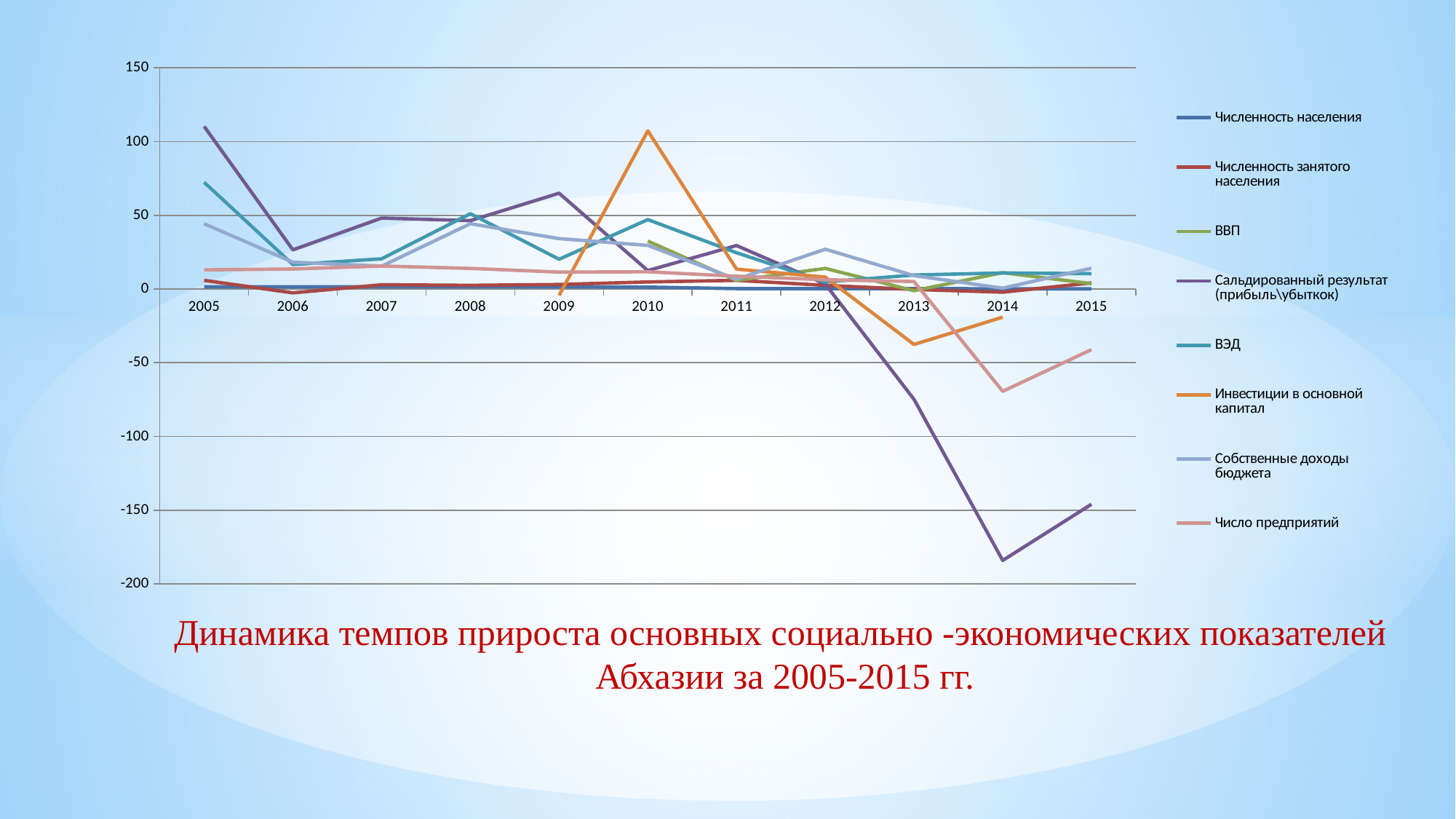
How many years are shown on the x axis? 11 In 2005, which is higher: Сальдированный результат (прибыль\убыток) or ВЭД? Сальдированный результат (прибыль\убыток) What kind of chart is shown on the slide? line chart Is the value for Сальдированный результат (прибыль\убыток) in 2014 greater or less than -150? less Does the Сальдированный результат (прибыль\убыток) line rise or fall from 2012 to 2014? fall In which year does Инвестиции в основной капитал reach its highest value? 2010 Is the value for ВЭД in 2005 greater or less than 50? greater Is the value for Инвестиции в основной капитал in 2010 greater or less than 100? greater What is the title shown below the chart? Динамика темпов прироста основных социально -экономических показателей Абхазии за 2005-2015 гг. How many series does the legend list? 8 In which year does Сальдированный результат (прибыль\убыток) reach its lowest value? 2014